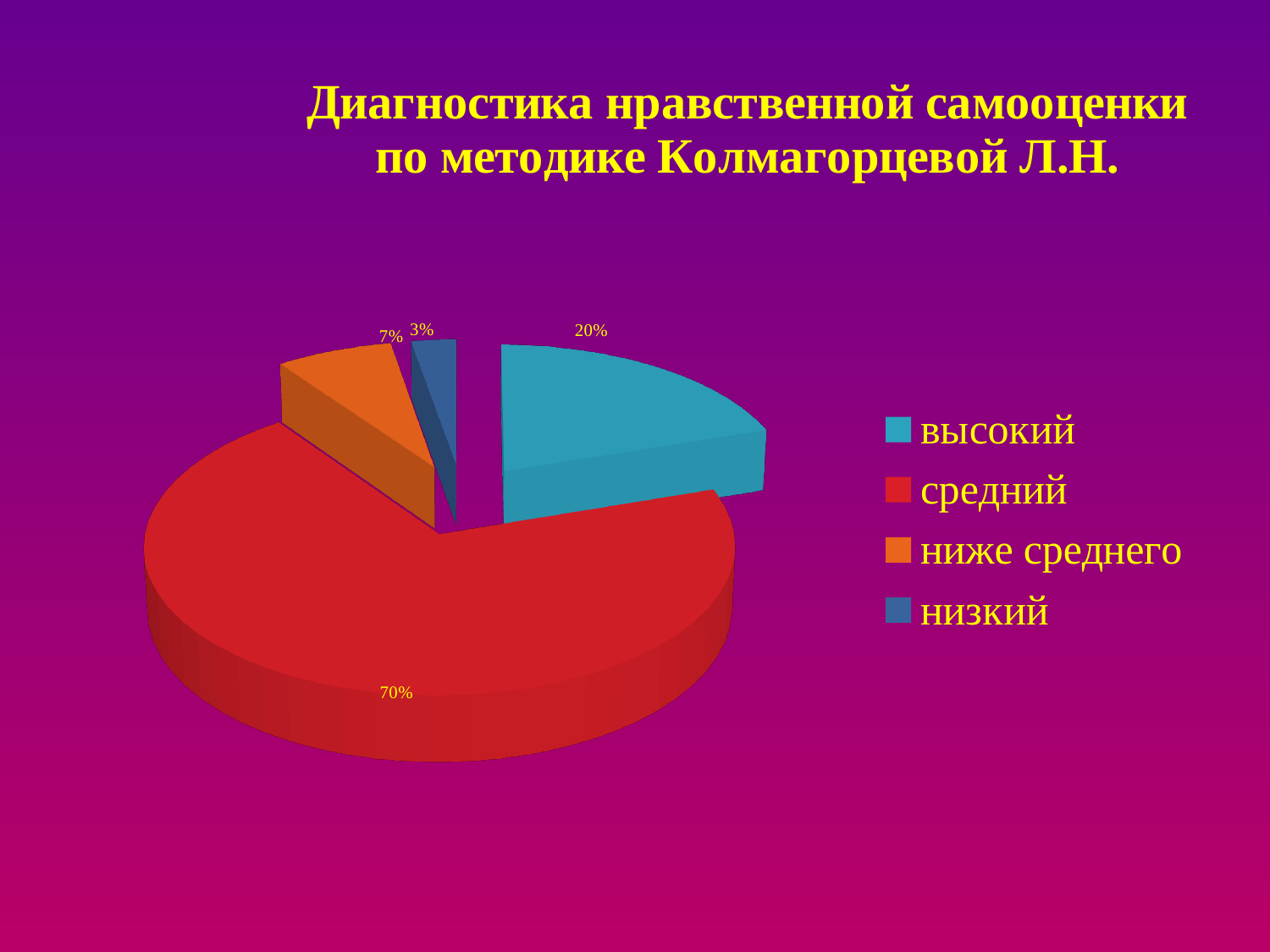
What percentage of the pie chart is labelled "высокий"? 20% What colour is the "средний" slice in the pie chart? red What type of chart is shown on the slide? pie chart Which slice is larger, "ниже среднего" or "низкий"? ниже среднего Which category has the largest slice of the pie chart? средний What percentage of the pie chart is labelled "средний"? 70% What percentage of the pie chart is labelled "ниже среднего"? 7% Which category has the smallest slice of the pie chart? низкий What is the difference in percentage points between the "средний" and "высокий" slices? 50 What percentage of the pie chart is labelled "низкий"? 3% What is the title of the slide containing the chart? Диагностика нравственной самооценки по методике Колмагорцевой Л.Н. How many categories does the pie chart show? 4